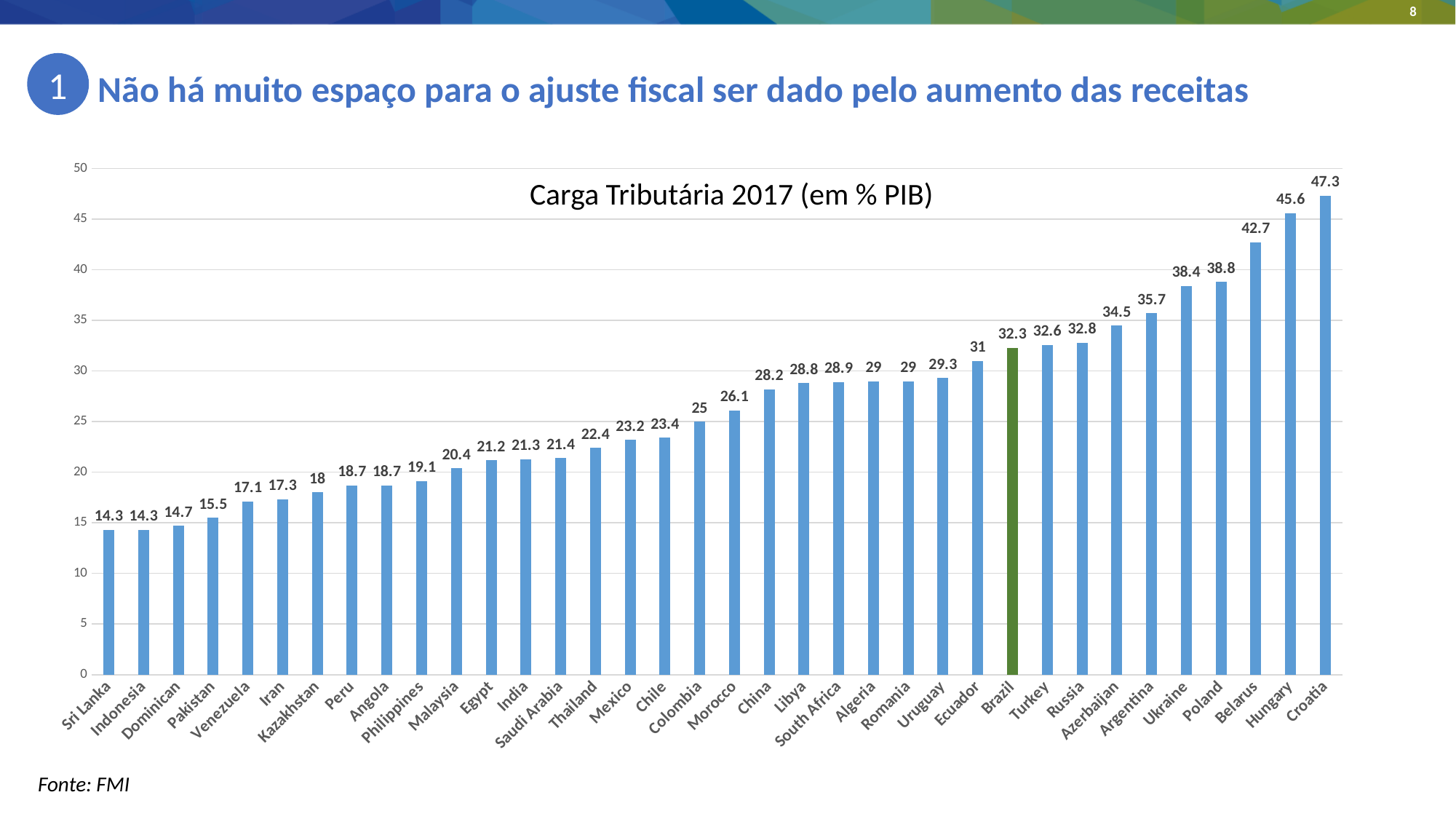
What kind of chart is shown on the slide? Bar chart What is the value for Brazil in the Carga Tributária 2017 chart? 32.3 How many countries are shown in the chart? 36 Which country's bar is coloured green in the chart? Brazil What is the value for Mexico in the chart? 23.2 Is the value for Hungary greater or less than 45? greater Which has a larger value, Poland or Ukraine? Poland What is the value for Argentina in the chart? 35.7 What is the lowest value shown in the chart? 14.3 Which country has the highest value in the chart? Croatia What is the difference between the values for Turkey and Sri Lanka? 18.3 What is the difference between the values for Croatia and Brazil? 15